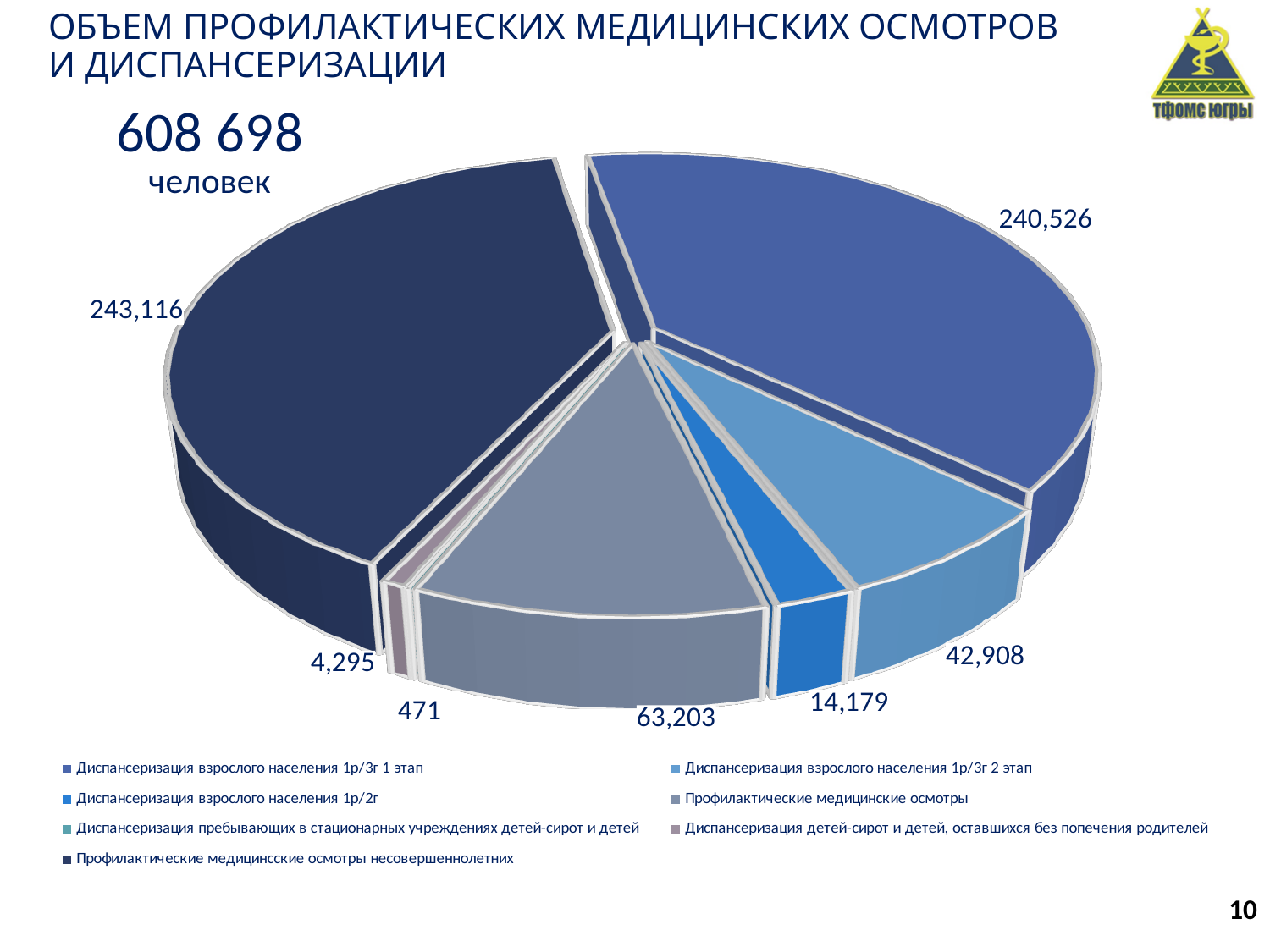
What is the value for 'Профилактические медицинские осмотры несовершеннолетних'? 243,116 What is the smallest value shown on the pie chart? 471 Which is larger: 'Профилактические медицинские осмотры' or 'Диспансеризация взрослого населения 1р/3г 2 этап'? Профилактические медицинские осмотры What is the difference between the values 243,116 and 240,526? 2,590 What is the value for 'Профилактические медицинские осмотры'? 63,203 What kind of chart is shown on the slide? pie chart Which category has the largest value in the pie chart? Профилактические медицинские осмотры несовершеннолетних What is the value for 'Диспансеризация взрослого населения 1р/3г 2 этап'? 42,908 What total number of people is stated on the slide? 608 698 What is the value for 'Диспансеризация взрослого населения 1р/2г'? 14,179 How many slices does the pie chart have? 7 What is the value for 'Диспансеризация взрослого населения 1р/3г 1 этап'? 240,526